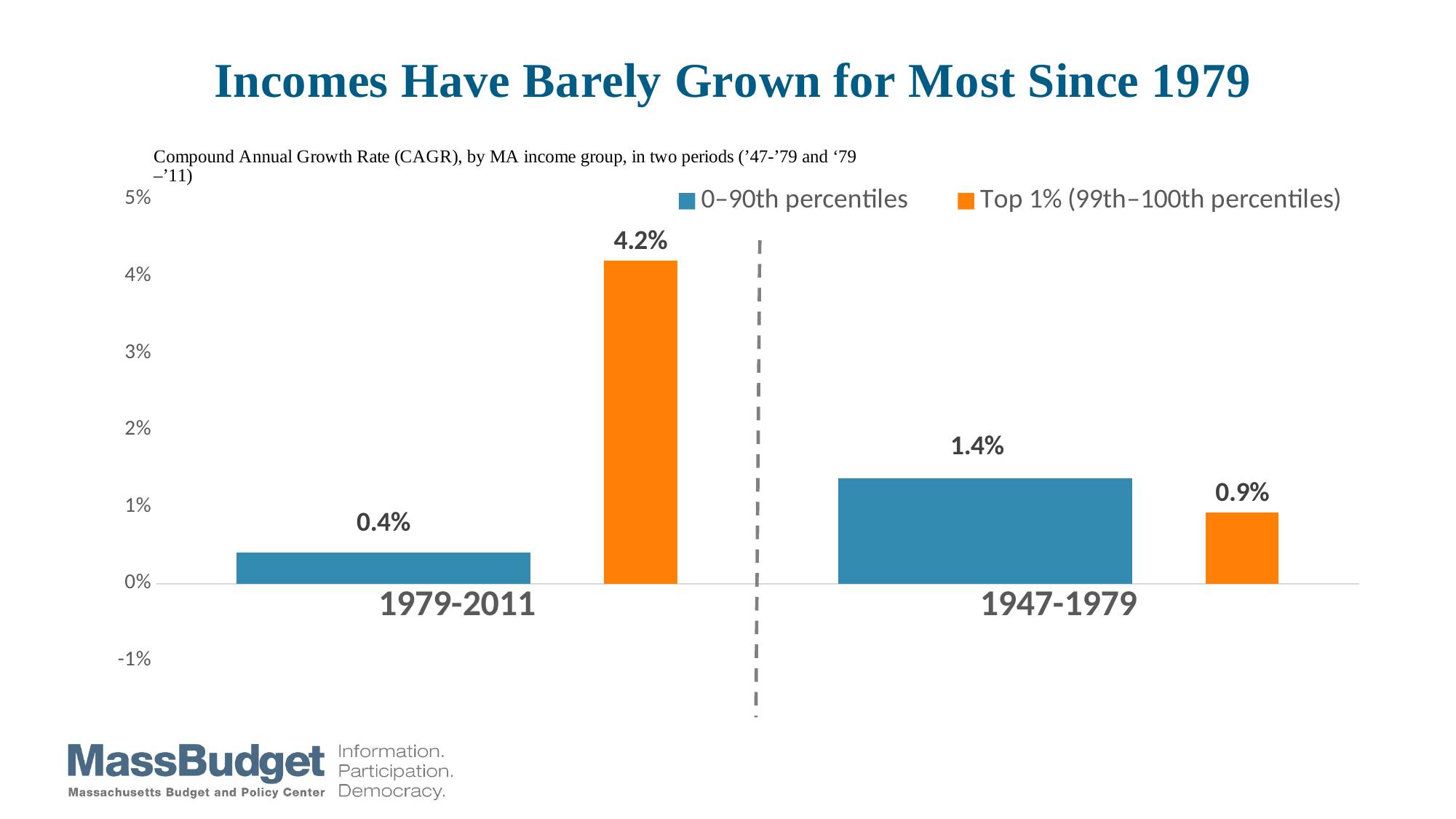
What is the value for the 0–90th percentiles in 1947-1979? 1.4% What is the value for the 0–90th percentiles in 1979-2011? 0.4% What kind of chart is shown on the slide? Bar chart Which bar has the highest value on the chart? Top 1% (99th–100th percentiles), 1979-2011 What is the value for the Top 1% (99th–100th percentiles) in 1979-2011? 4.2% What is the difference between the Top 1% and the 0–90th percentiles values in 1979-2011? 3.8% How many series does the legend list? 2 In 1947-1979, which group has the larger value: the 0–90th percentiles or the Top 1%? 0–90th percentiles What is the value for the Top 1% (99th–100th percentiles) in 1947-1979? 0.9% What is the difference between the 0–90th percentiles and the Top 1% values in 1947-1979? 0.5% Which bar has the lowest value on the chart? 0–90th percentiles, 1979-2011 What colour represents the Top 1% (99th–100th percentiles) series? Orange